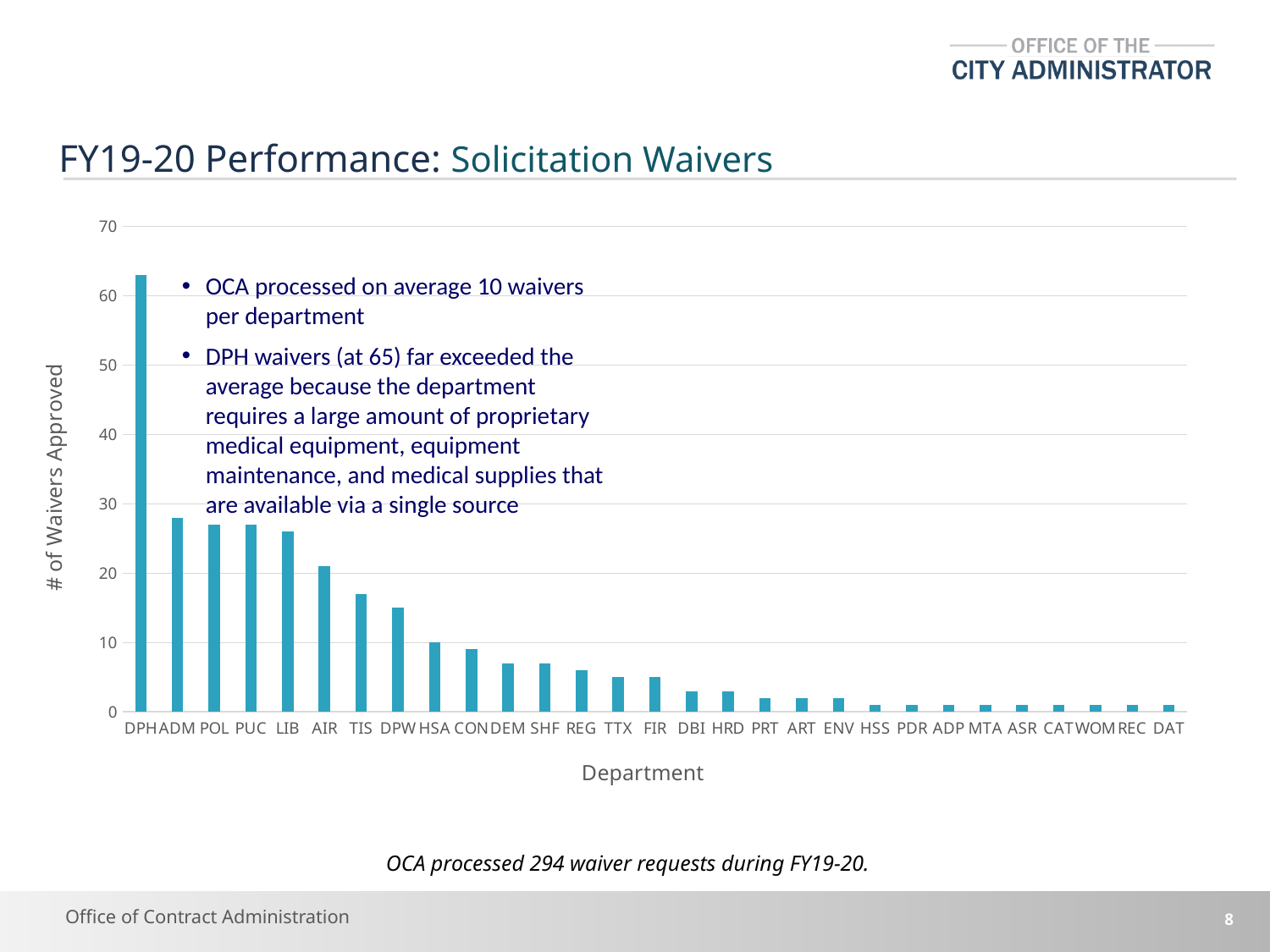
Which department has the highest number of waivers approved? DPH How many departments are shown on the x axis of the chart? 29 Is the value for ADM greater or less than 20? greater According to the slide, how many waivers did DPH have? 65 Do the bar values rise or fall moving from left to right along the x axis? fall What is the label of the vertical axis of the chart? # of Waivers Approved Is the value for DPW greater or less than 10? greater Which department has more waivers approved, ADM or TIS? ADM Is the value for TIS greater or less than 20? less What kind of chart is shown on the slide? bar chart